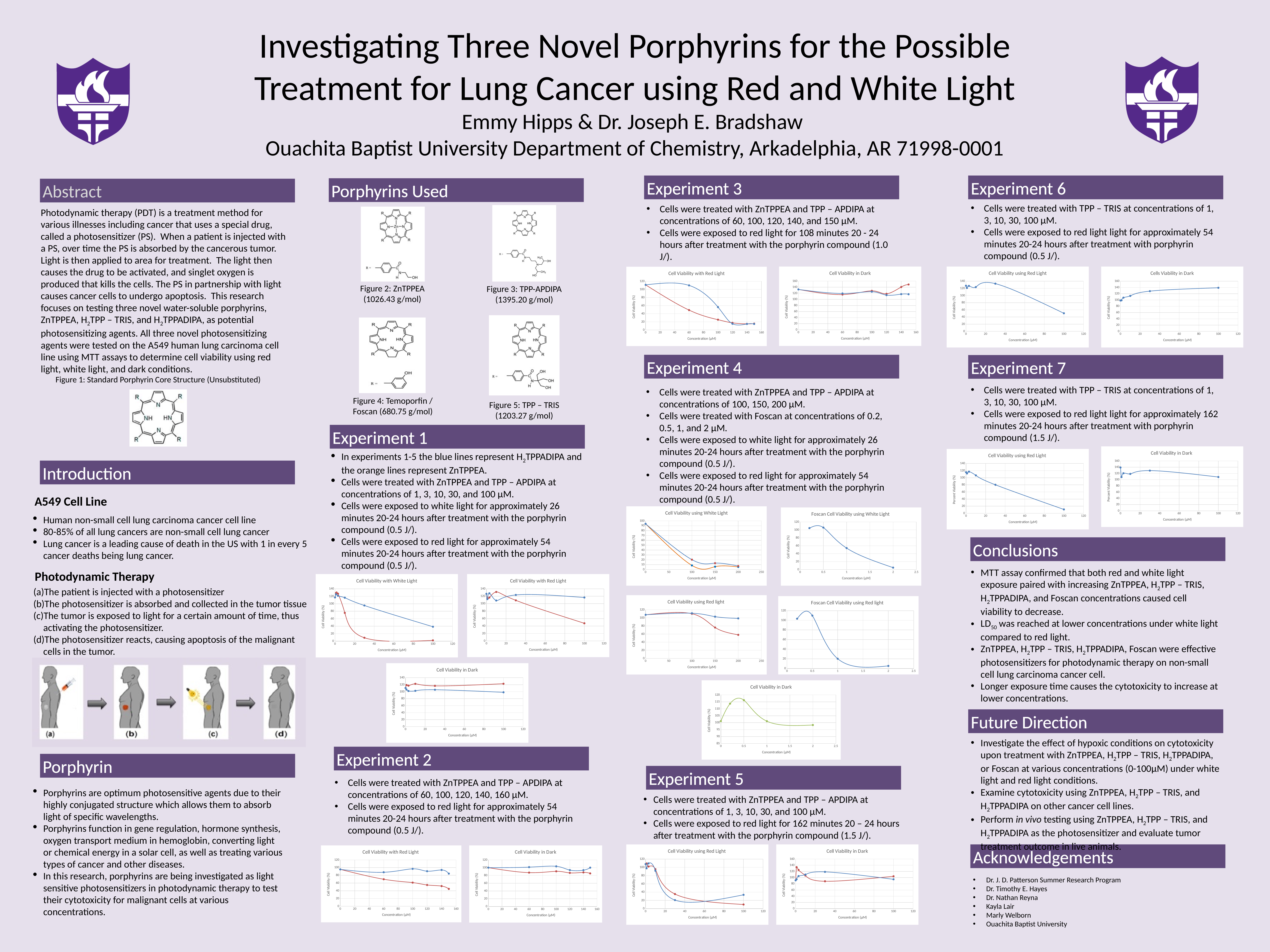
In the Experiment 1 'Cell Viability with White Light' chart, does the red line rise or fall as concentration increases? fall In the Experiment 1 'Cell Viability with Red Light' chart, is the blue line's value at 100 µM greater or less than 80? greater In the Experiment 4 'Foscan Cell Viability using White Light' chart, how many data points are plotted? 4 In the Experiment 7 'Cell Viability using Red Light' chart, does cell viability rise or fall as concentration increases? fall In the Experiment 1 'Cell Viability with White Light' chart, is the red line's value at 100 µM greater or less than 20? less What is the title of the chart in the Experiment 4 section that uses a green line? Cell Viability in Dark In the Experiment 4 'Cell Viability using Red light' chart, which line is higher at 200 µM, the blue line or the red line? blue line In the Experiment 4 'Foscan Cell Viability using White Light' chart, is the value at 2 µM greater or less than 20? less In the Experiment 1 'Cell Viability with White Light' chart, what kind of chart is shown? line chart What is the x-axis label on the Experiment 2 'Cell Viability with Red Light' chart? Concentration (µM)